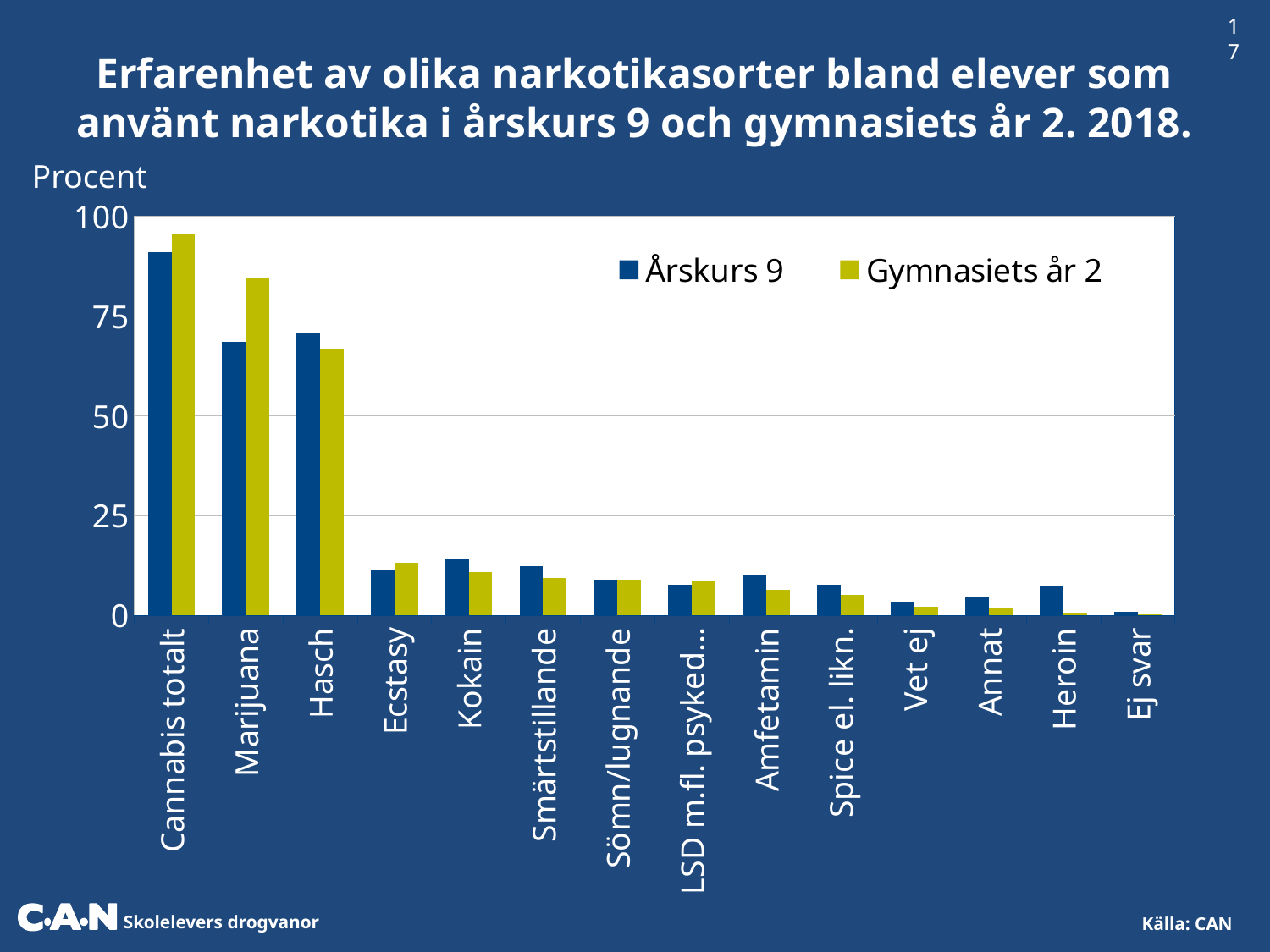
What are the two series listed in the legend? Årskurs 9 and Gymnasiets år 2 Is the value for Marijuana in Gymnasiets år 2 greater or less than 75? greater Is the value for Hasch in Årskurs 9 greater or less than 75? less Is the value for Ecstasy in Årskurs 9 greater or less than 25? less Which category has the highest value for Gymnasiets år 2? Cannabis totalt What kind of chart is shown on the slide? Bar chart How many categories are shown on the x axis? 14 Which category has the lowest value for Årskurs 9? Ej svar How many series does the legend list? 2 Which category has the highest value for Årskurs 9? Cannabis totalt For Marijuana, which series has the larger value: Årskurs 9 or Gymnasiets år 2? Gymnasiets år 2